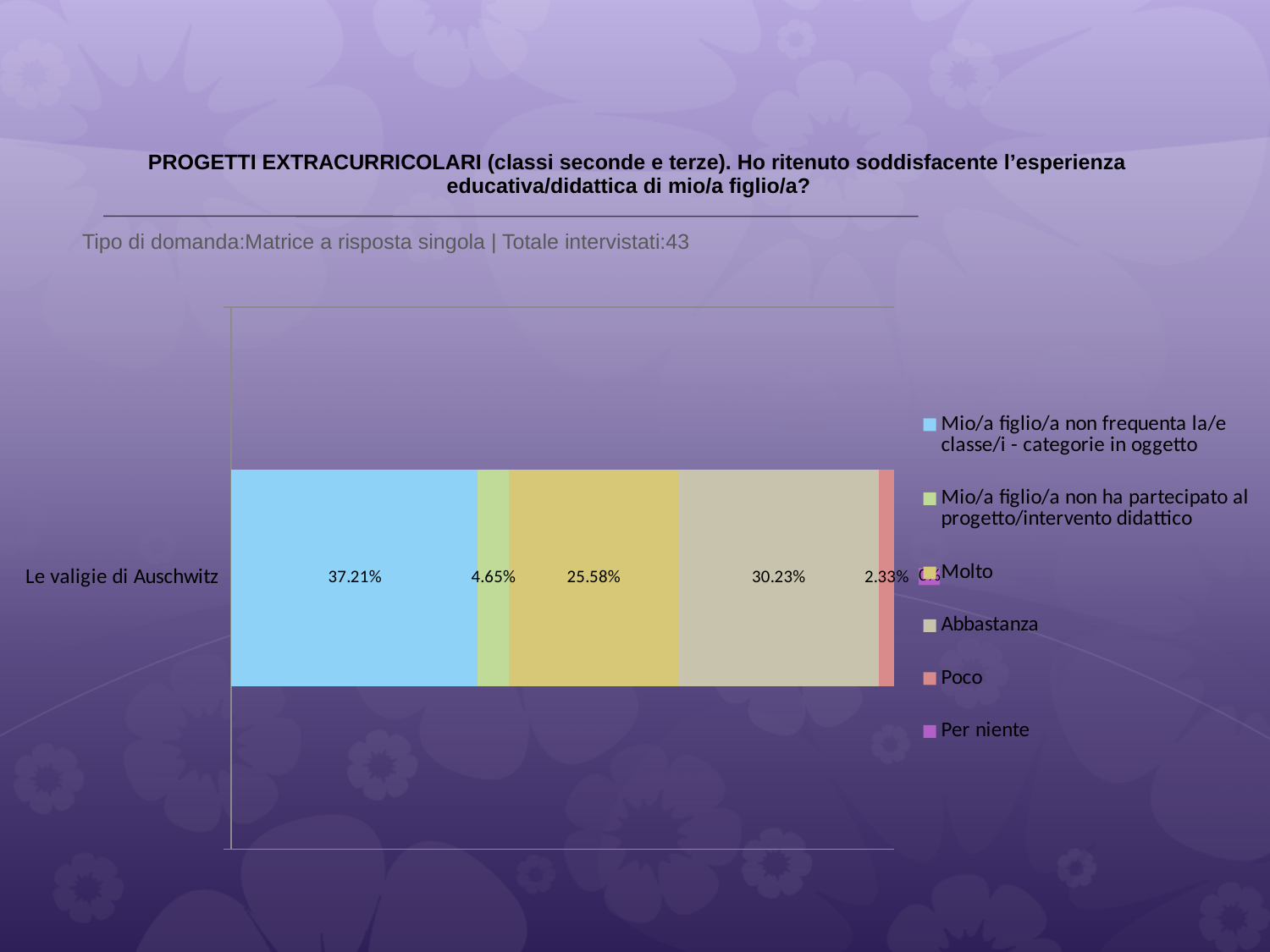
What is the value for 'Poco' for Le valigie di Auschwitz? 2.33% What is the value for 'Abbastanza' for Le valigie di Auschwitz? 30.23% What is the difference between the value for 'Abbastanza' and the value for 'Molto'? 4.65% What is the value for 'Molto' for Le valigie di Auschwitz? 25.58% Which series has the largest value in the bar for Le valigie di Auschwitz? Mio/a figlio/a non frequenta la/e classe/i - categorie in oggetto What is the value for 'Mio/a figlio/a non frequenta la/e classe/i - categorie in oggetto'? 37.21% What kind of chart is shown on the slide? Stacked bar chart How many categories are plotted on the y axis? 1 What is the name of the category shown on the y axis? Le valigie di Auschwitz What is the value for 'Mio/a figlio/a non ha partecipato al progetto/intervento didattico'? 4.65% How many series does the legend list? 6 Which is larger, the value for 'Abbastanza' or the value for 'Molto'? Abbastanza